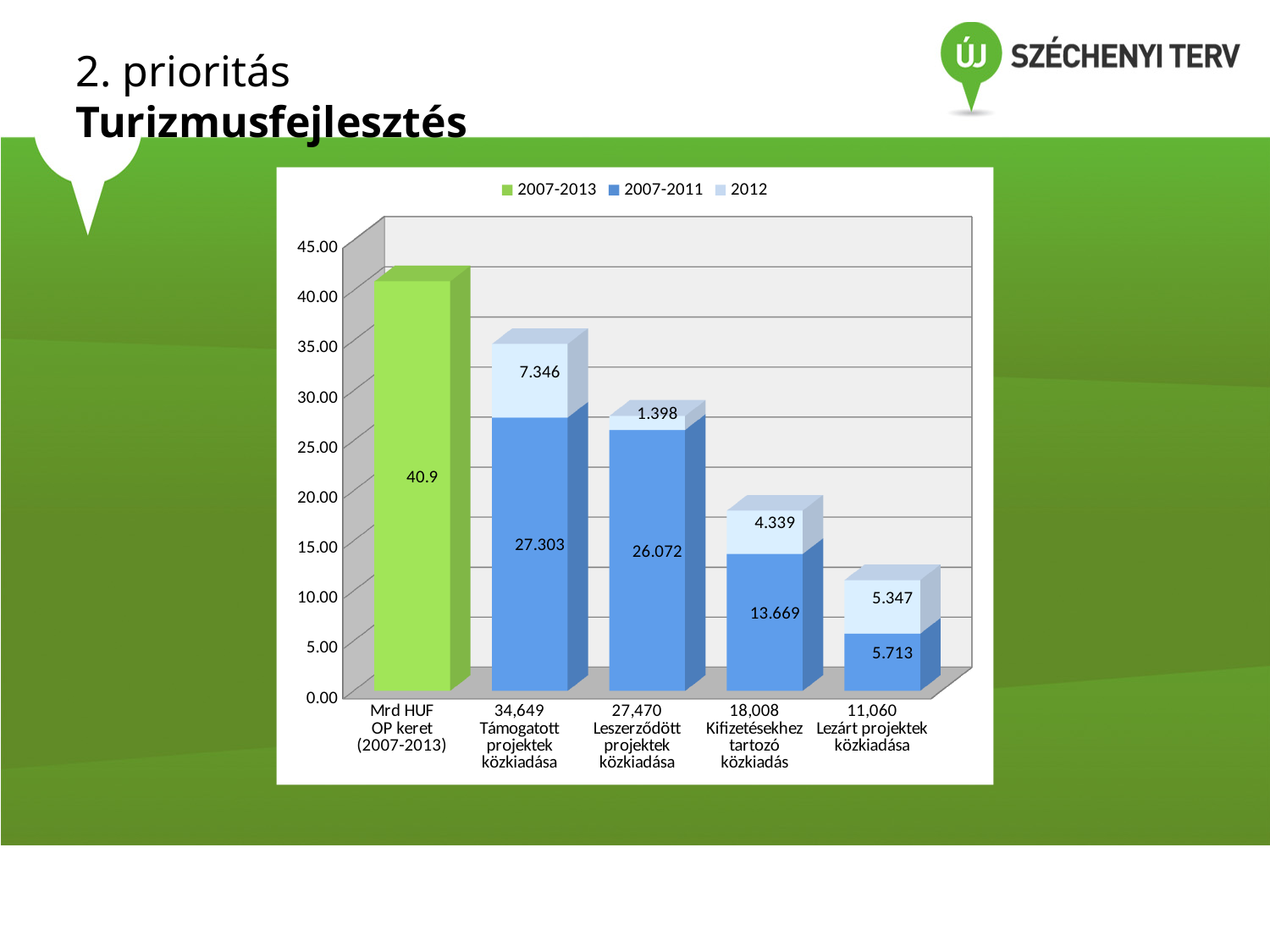
Which category has the lowest 2007-2011 value? Lezárt projektek közkiadása What is the difference between the 2007-2011 values for Támogatott projektek közkiadása and Leszerződött projektek közkiadása? 1.231 What is the value of the 2007-2011 series for Támogatott projektek közkiadása? 27.303 What is the total of the stacked bar for Kifizetésekhez tartozó közkiadás? 18.008 What is the value of the 2012 series for Lezárt projektek közkiadása? 5.347 What is the value shown for the Mrd HUF OP keret (2007-2013) bar? 40.9 What is the value of the 2007-2011 series for Kifizetésekhez tartozó közkiadás? 13.669 What kind of chart is shown on the slide? Stacked bar chart How many series does the legend list? 3 Which category has the highest 2012 value? Támogatott projektek közkiadása Is the 2012 value larger for Kifizetésekhez tartozó közkiadás or for Leszerződött projektek közkiadása? Kifizetésekhez tartozó közkiadás What is the value of the 2012 series for Leszerződött projektek közkiadása? 1.398